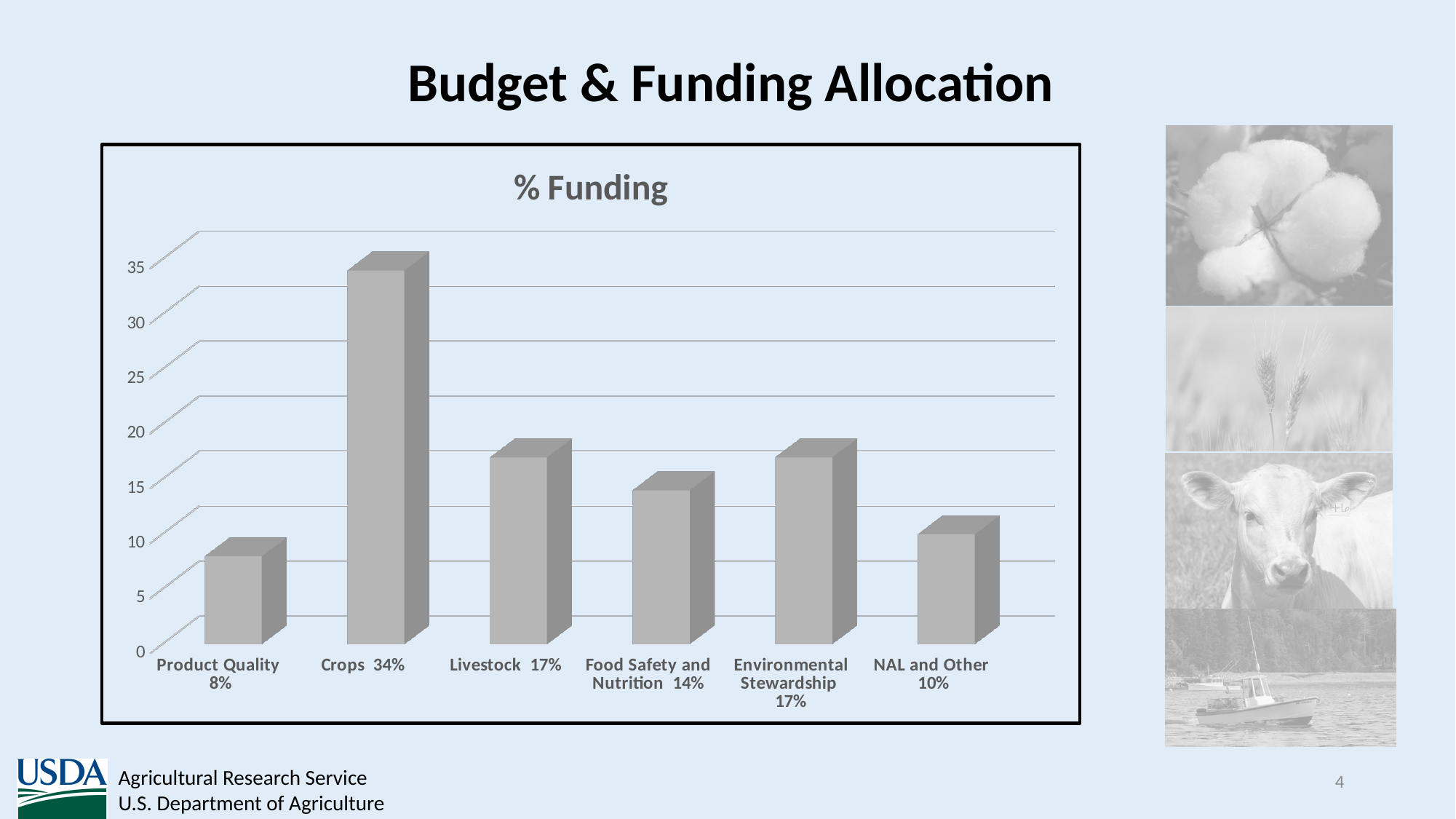
What percentage of funding goes to Food Safety and Nutrition? 14% Which category receives the highest share of funding? Crops What percentage of funding goes to Product Quality? 8% What is the title of the chart? % Funding What is the difference in funding percentage between Crops and Livestock? 17% How many categories are shown in the chart? 6 Which receives more funding, Food Safety and Nutrition or NAL and Other? Food Safety and Nutrition What percentage of funding goes to Crops? 34% What kind of chart is shown on the slide? bar chart Is the value for Crops greater or less than 30? greater Which category receives the lowest share of funding? Product Quality What percentage of funding goes to NAL and Other? 10%